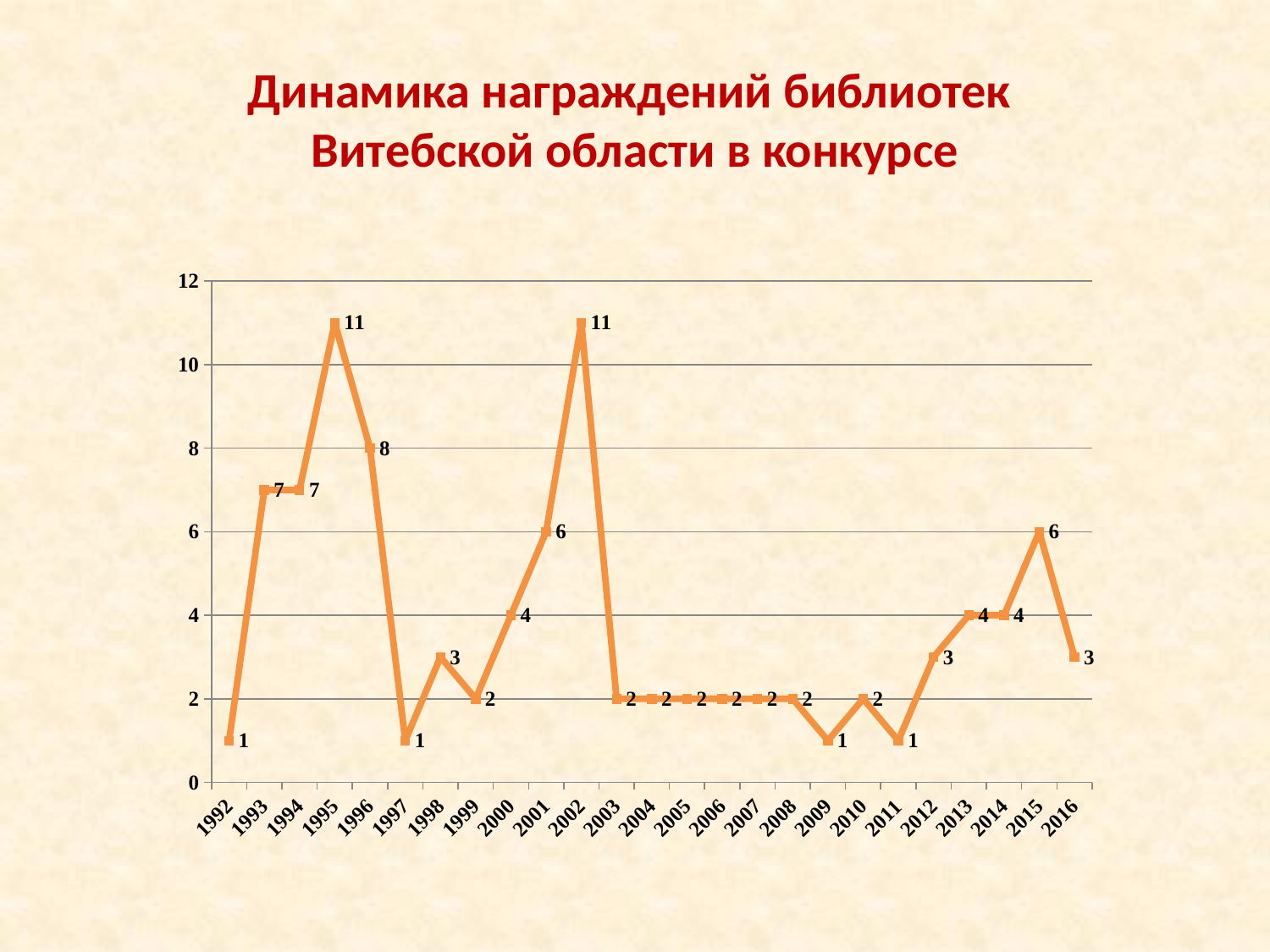
What is the value for 2001? 6 How many years are plotted on the x axis? 25 Do the values rise or fall from 2011 to 2015? Rise What kind of chart is shown on the slide? Line chart What is the value for 2016? 3 What is the value for 2009? 1 Which year has the larger value, 1993 or 1998? 1993 What is the difference between the values for 2015 and 2012? 3 Which year has the larger value, 2000 or 2013? 2013 and 2000 have the same value (4) What is the difference between the values for 1996 and 1997? 7 What is the value for 1995? 11 What is the highest value plotted on the chart? 11